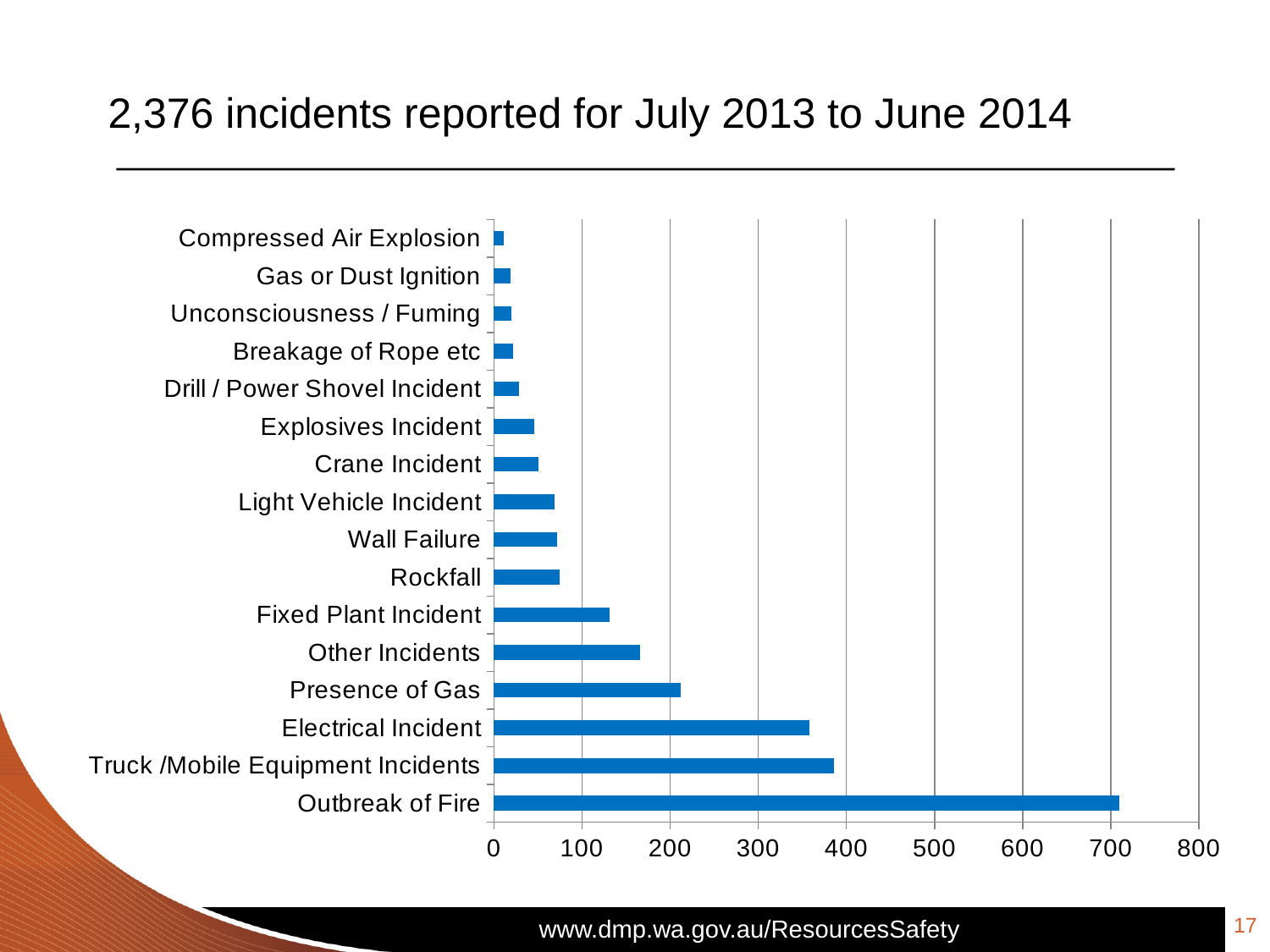
What is the highest value shown on the horizontal axis of the chart? 800 Is the value for Outbreak of Fire greater or less than 600? greater Which incident category has the highest number of incidents? Outbreak of Fire Which has more incidents, Presence of Gas or Other Incidents? Presence of Gas Is the value for Electrical Incident greater or less than 400? less Is the value for Rockfall greater or less than 100? less Which incident category has the lowest number of incidents? Compressed Air Explosion How many incident categories are plotted in the chart? 16 What kind of chart is shown on the slide? Bar chart